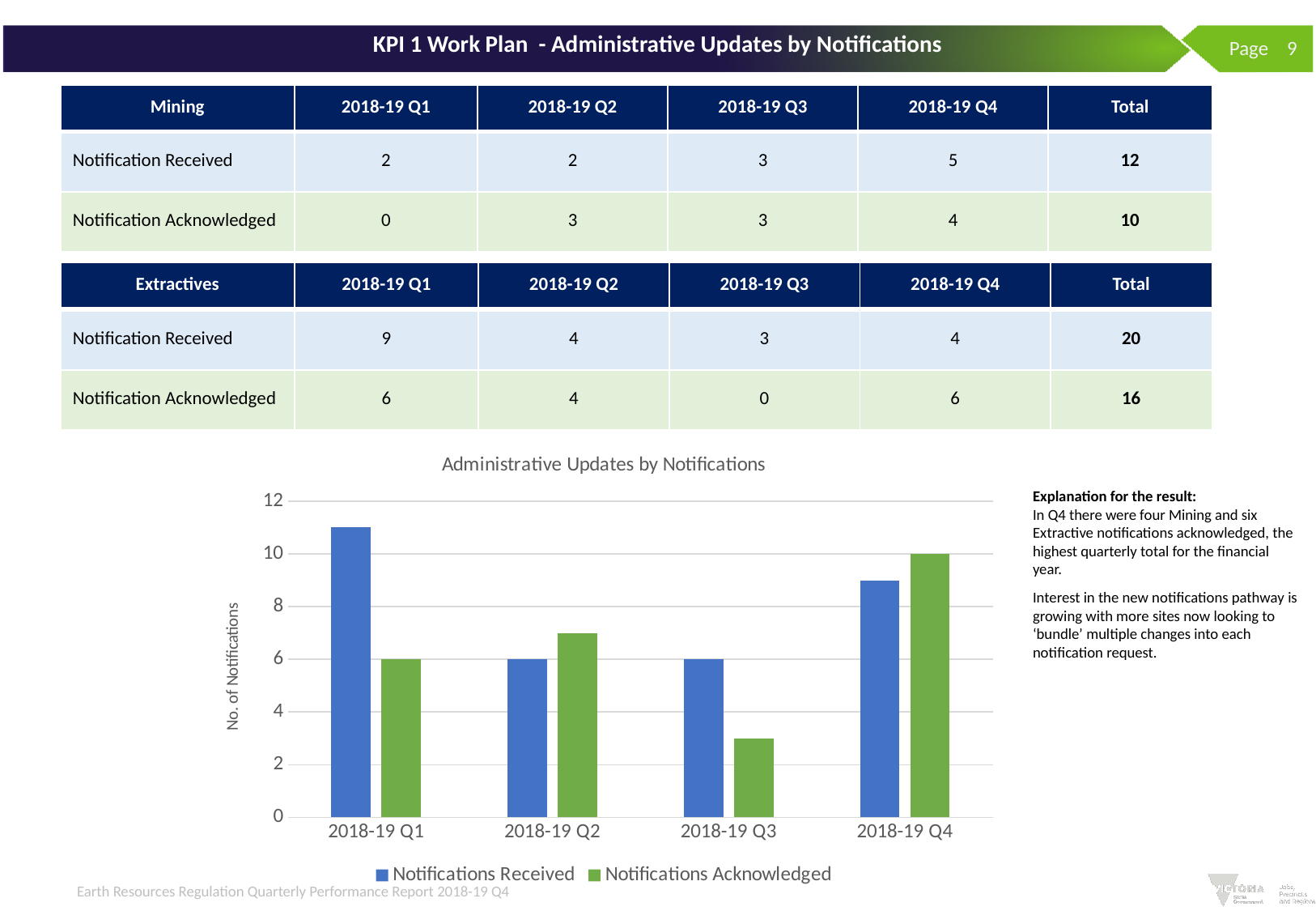
Is the value for Notifications Received in 2018-19 Q1 greater or less than 10? greater What is the value of Notifications Acknowledged for 2018-19 Q4 in the chart? 10 Which quarter has the highest value for Notifications Received? 2018-19 Q1 Which quarter has the lowest value for Notifications Acknowledged? 2018-19 Q3 How many quarters are shown on the x axis of the chart? 4 How many series does the chart legend list? 2 What is the value of Notifications Received for 2018-19 Q2 in the chart? 6 In 2018-19 Q1, which is larger: Notifications Received or Notifications Acknowledged? Notifications Received What kind of chart is shown on the slide? bar chart What is the value of Notifications Acknowledged for 2018-19 Q1 in the chart? 6 Is the value for Notifications Acknowledged in 2018-19 Q3 greater or less than 4? less Is the value for Notifications Received in 2018-19 Q4 greater or less than 8? greater